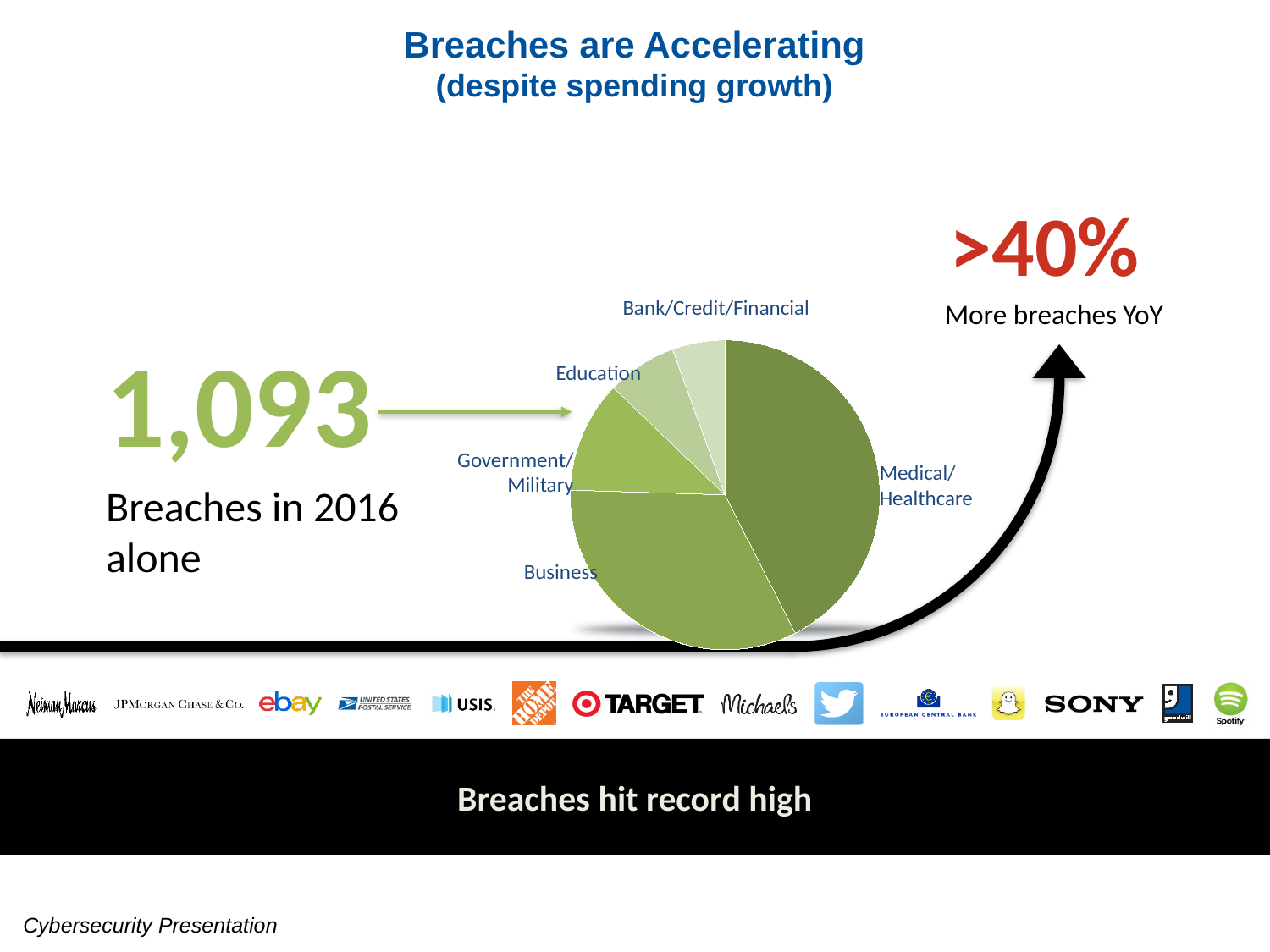
Which slice is larger in the pie chart, Medical/Healthcare or Business? Medical/Healthcare What is the title of the slide containing the pie chart? Breaches are Accelerating (despite spending growth) How many slices does the pie chart have? 5 Which slice is larger in the pie chart, Business or Government/Military? Business Which category has the smallest slice of the pie chart? Bank/Credit/Financial Which slice is larger in the pie chart, Government/Military or Education? Government/Military What kind of chart is shown on the slide? pie chart Which category has the largest slice of the pie chart? Medical/Healthcare What total number of breaches in 2016 does the slide state the pie chart breaks down? 1,093